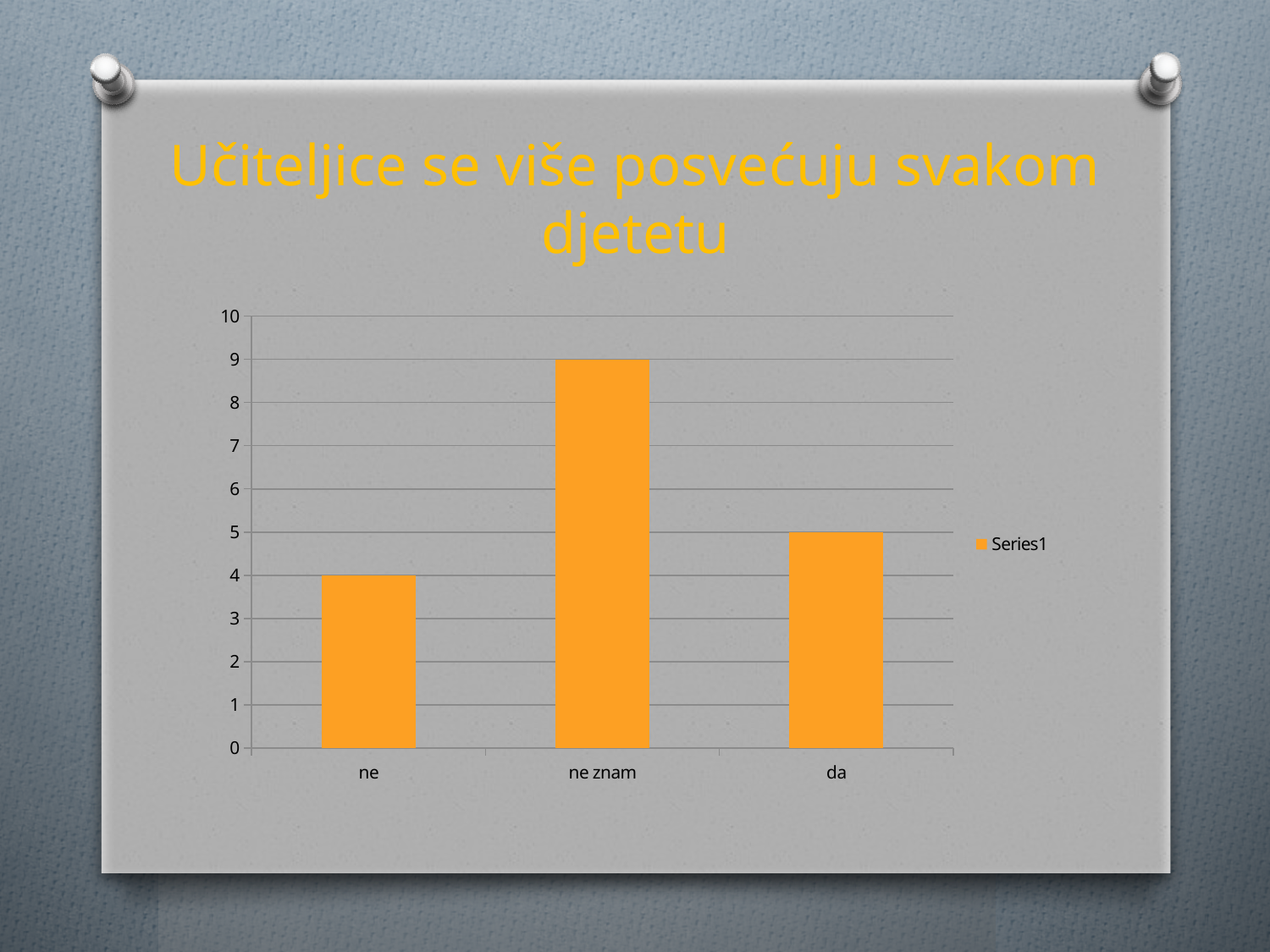
What is the value for "ne"? 4 Which category has the lowest value? ne What is the value for "da"? 5 Which is larger, the value for "da" or the value for "ne"? da Is the value for "ne znam" greater or less than 8? greater What kind of chart is shown on the slide? bar chart What is the difference between the values for "da" and "ne"? 1 What is the value for "ne znam"? 9 How many categories are shown on the x axis? 3 Which category has the highest value? ne znam What is the difference between the values for "ne znam" and "da"? 4 How many series does the legend list? 1